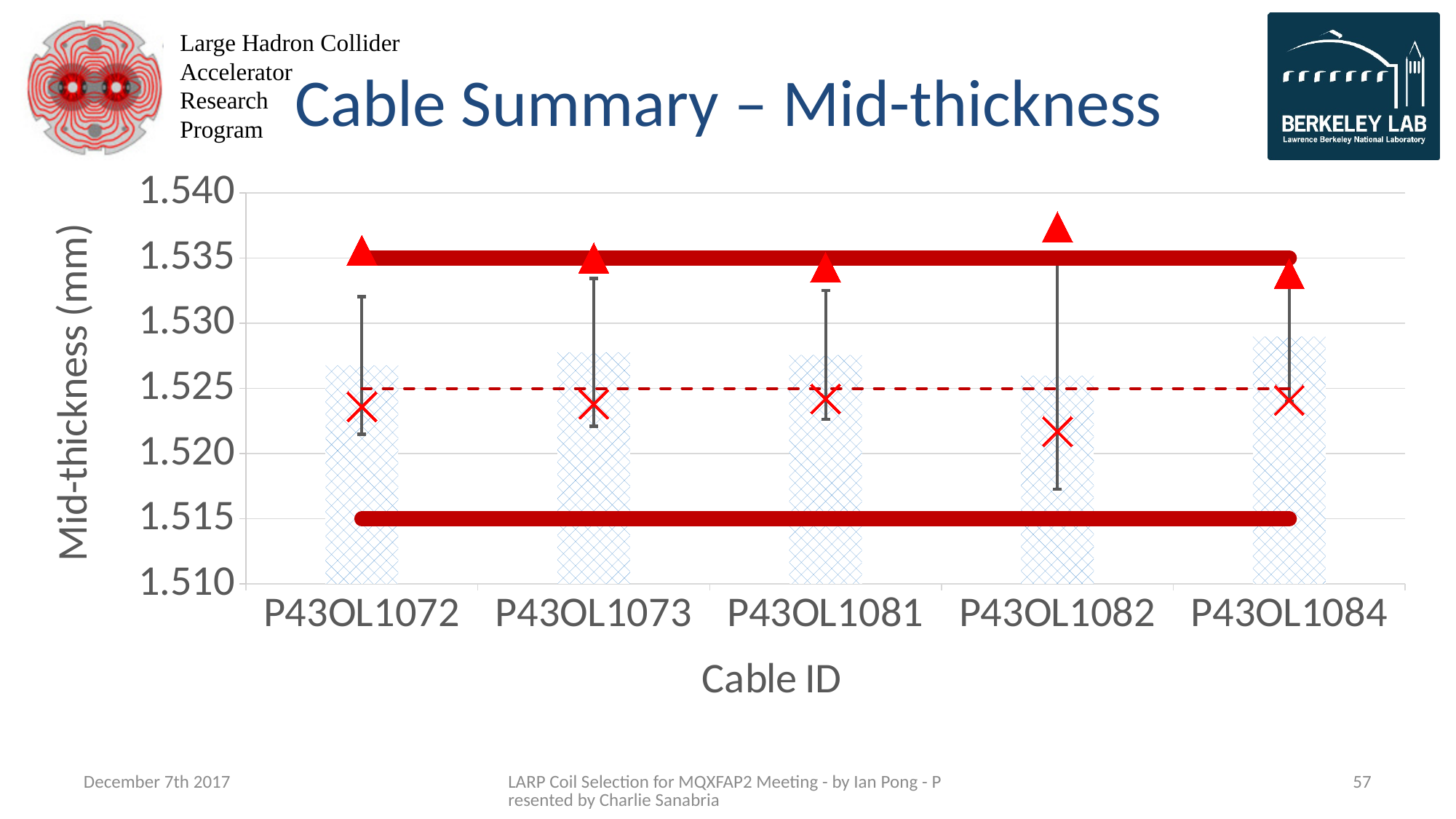
Which cable ID has the highest red triangle marker? P43OL1082 How many cable IDs are shown on the x axis of the chart? 5 What is the title of the vertical axis of the chart? Mid-thickness (mm) Is the hatched bar for P43OL1082 greater or less than 1.530? less What kind of chart is shown on the slide? bar chart Is the hatched bar for P43OL1084 greater or less than 1.525? greater Which cable ID has the lowest red X marker? P43OL1082 Is the hatched bar for P43OL1073 taller or shorter than the hatched bar for P43OL1082? taller Is the red triangle marker for P43OL1082 greater or less than 1.535? greater Which cable ID has the tallest hatched bar? P43OL1084 At which two values on the vertical axis are the thick solid red horizontal lines drawn? 1.535 and 1.515